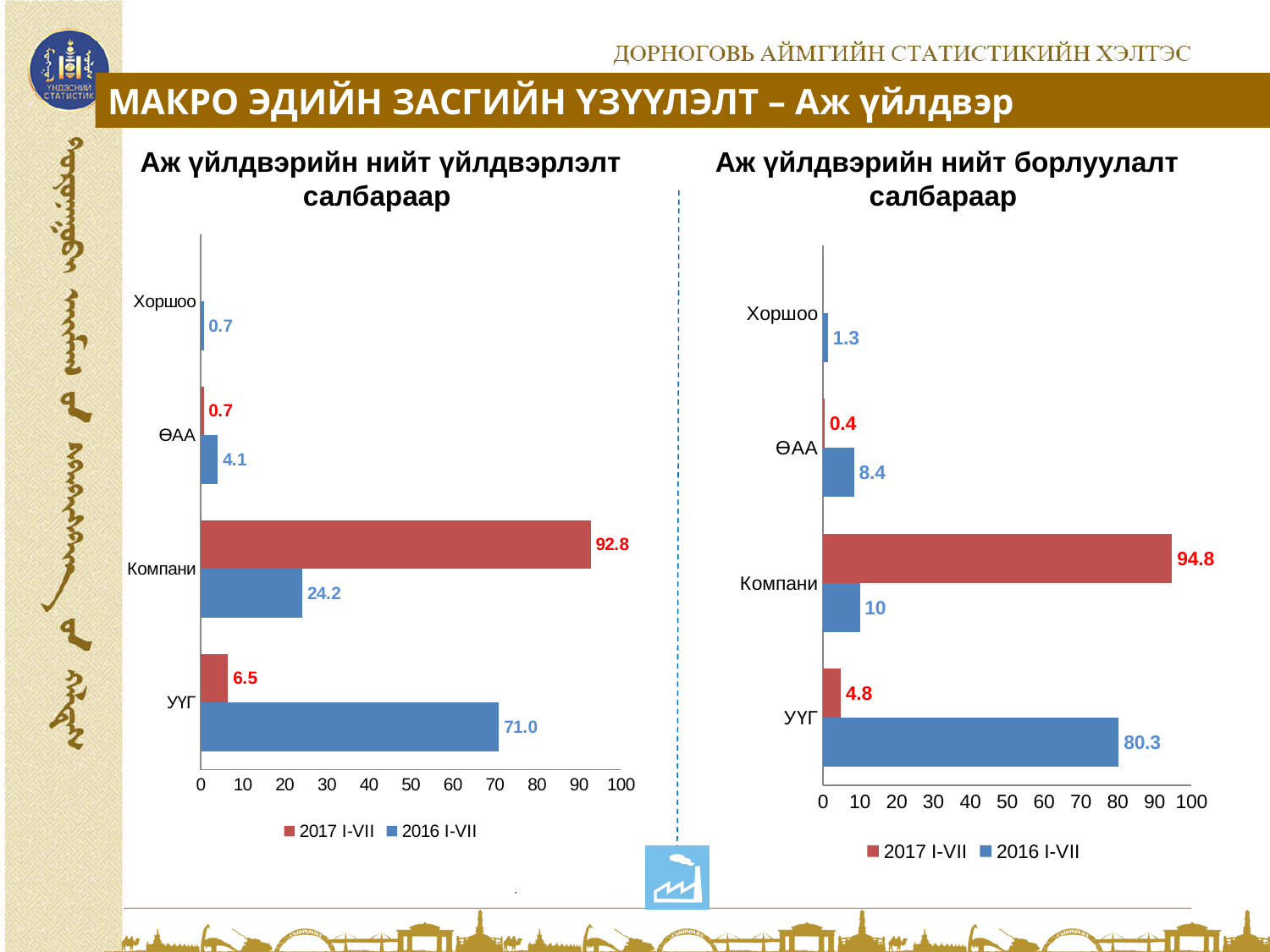
In the right chart (Аж үйлдвэрийн нийт борлуулалт салбараар), what is the 2017 I-VII value for УҮГ? 4.8 In the left chart (Аж үйлдвэрийн нийт үйлдвэрлэлт салбараар), how many series does the legend list? 2 In the right chart (Аж үйлдвэрийн нийт борлуулалт салбараар), which is larger for УҮГ: the 2017 I-VII value or the 2016 I-VII value? 2016 I-VII In the right chart (Аж үйлдвэрийн нийт борлуулалт салбараар), what is the 2016 I-VII value for ӨАА? 8.4 In the left chart (Аж үйлдвэрийн нийт үйлдвэрлэлт салбараар), which category has the highest 2016 I-VII value? УҮГ What type of chart is the left chart (Аж үйлдвэрийн нийт үйлдвэрлэлт салбараар)? Bar chart In the left chart (Аж үйлдвэрийн нийт үйлдвэрлэлт салбараар), what is the difference between the 2017 I-VII and 2016 I-VII values for Компани? 68.6 In the right chart (Аж үйлдвэрийн нийт борлуулалт салбараар), which category has the highest 2017 I-VII value? Компани How many categories are shown on the y axis of the right chart (Аж үйлдвэрийн нийт борлуулалт салбараар)? 4 In the left chart (Аж үйлдвэрийн нийт үйлдвэрлэлт салбараар), what is the 2017 I-VII value for Компани? 92.8 In the right chart (Аж үйлдвэрийн нийт борлуулалт салбараар), what is the difference between the 2016 I-VII and 2017 I-VII values for УҮГ? 75.5 In the left chart (Аж үйлдвэрийн нийт үйлдвэрлэлт салбараар), what is the 2016 I-VII value for УҮГ? 71.0